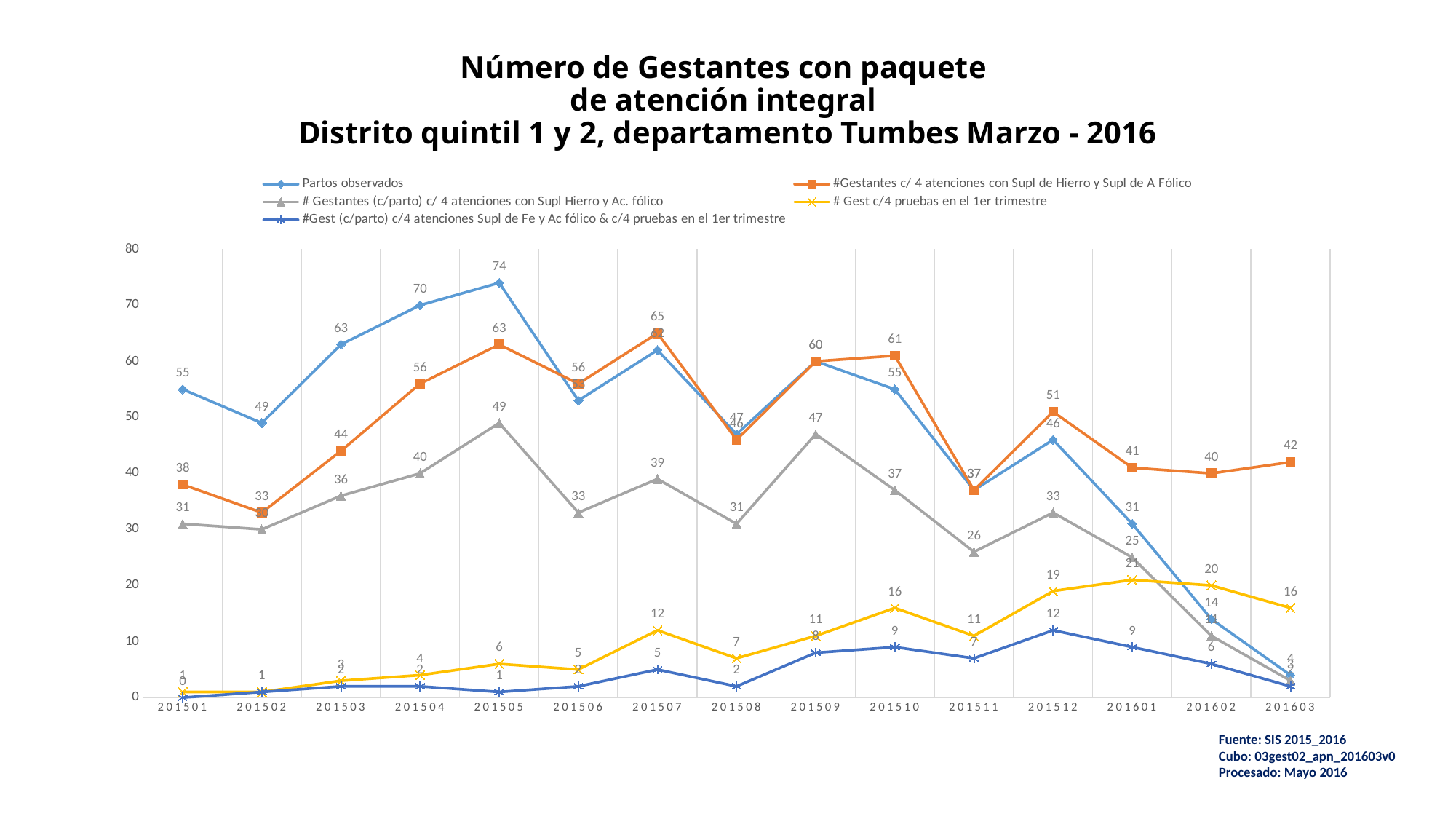
Is the value of Partos observados in 201504 greater or less than 60? greater How many series does the legend list? 5 What is the value of #Gestantes c/ 4 atenciones con Supl de Hierro y Supl de A Fólico in 201603? 42 What is the difference between Partos observados in 201505 and in 201501? 19 In which period is Partos observados highest? 201505 How many periods are shown along the x axis? 15 What is the value of # Gestantes (c/parto) c/ 4 atenciones con Supl Hierro y Ac. fólico in 201505? 49 What type of chart is shown on the slide? line chart Does Partos observados rise or fall from 201512 to 201603? fall What is the value of Partos observados in 201505? 74 What is the value of # Gest c/4 pruebas en el 1er trimestre in 201602? 20 In 201603, which is larger: Partos observados or #Gestantes c/ 4 atenciones con Supl de Hierro y Supl de A Fólico? #Gestantes c/ 4 atenciones con Supl de Hierro y Supl de A Fólico